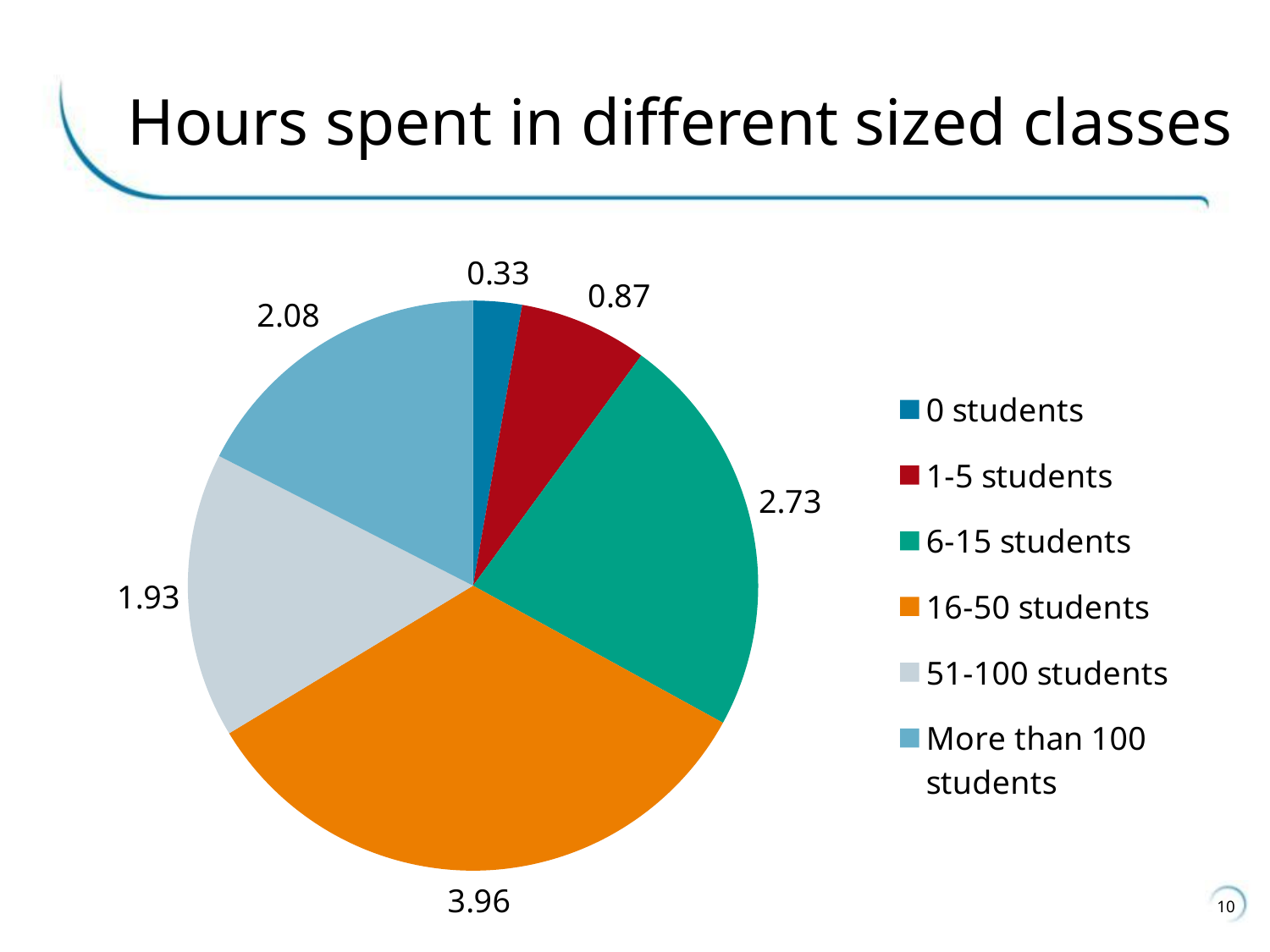
How many categories does the pie chart have? 6 Which is larger, the value for 51-100 students or the value for More than 100 students? More than 100 students Which category has the smallest slice? 0 students What is the title of the chart? Hours spent in different sized classes What is the total of all the values shown in the pie chart? 11.90 Which category has the largest slice? 16-50 students What is the value for 6-15 students? 2.73 What type of chart is shown on the slide? pie chart What is the value for More than 100 students? 2.08 What is the value for 0 students? 0.33 What is the value for 16-50 students? 3.96 What is the difference between the values for 16-50 students and 6-15 students? 1.23